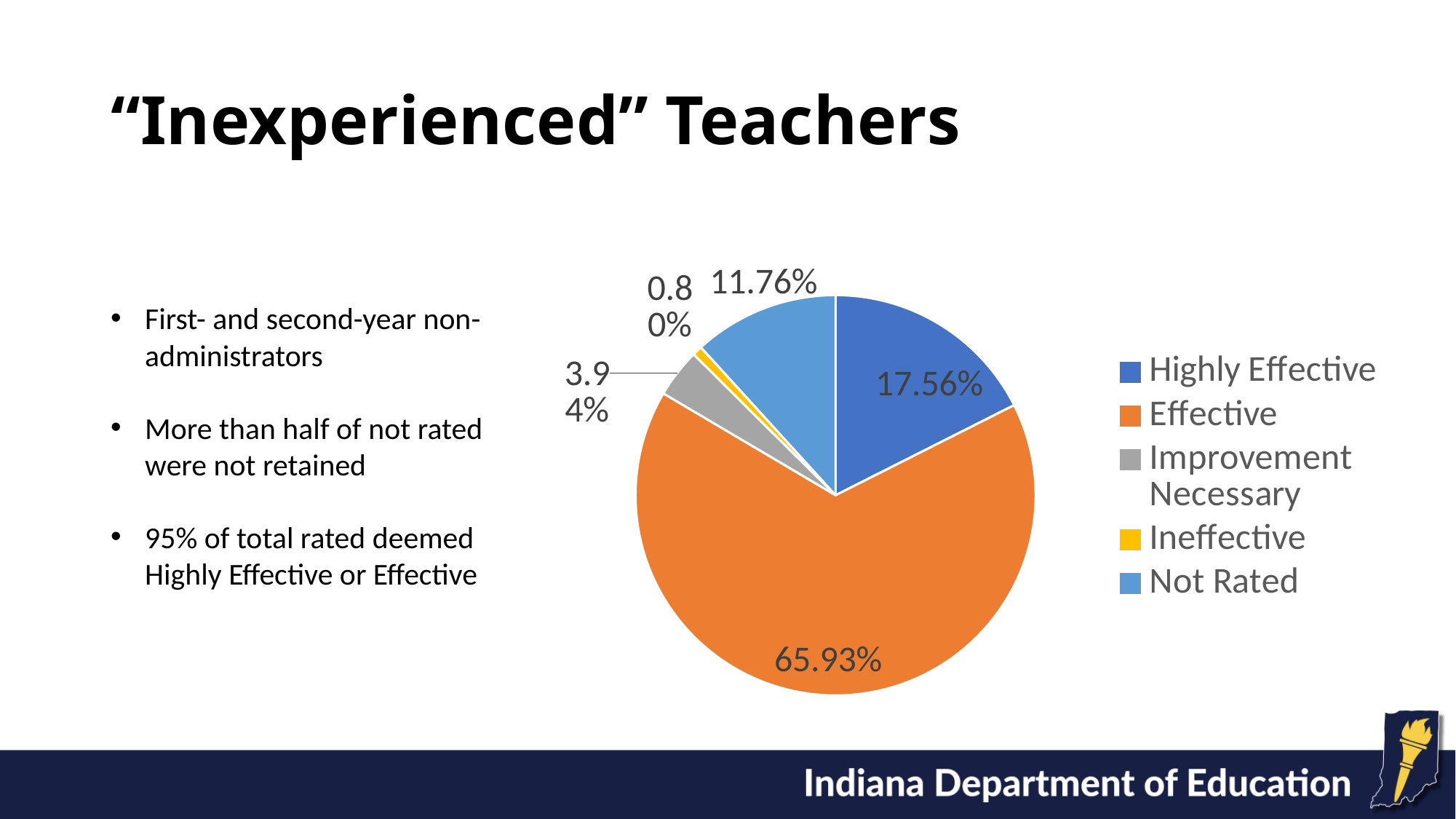
Which category has the largest slice of the pie? Effective What colour is the Ineffective slice in the legend? yellow Which slice is larger, Highly Effective or Not Rated? Highly Effective What is the combined percentage of Highly Effective and Effective? 83.49% What percentage of the pie is labelled for Not Rated? 11.76% How many categories does the pie chart have? 5 Which category has the smallest slice of the pie? Ineffective What percentage of the pie is labelled for Improvement Necessary? 3.94% What is the difference between the Effective and Highly Effective percentages? 48.37% What percentage of the pie is labelled for Effective? 65.93% What kind of chart is shown on the slide? pie chart What percentage of the pie is labelled for Highly Effective? 17.56%